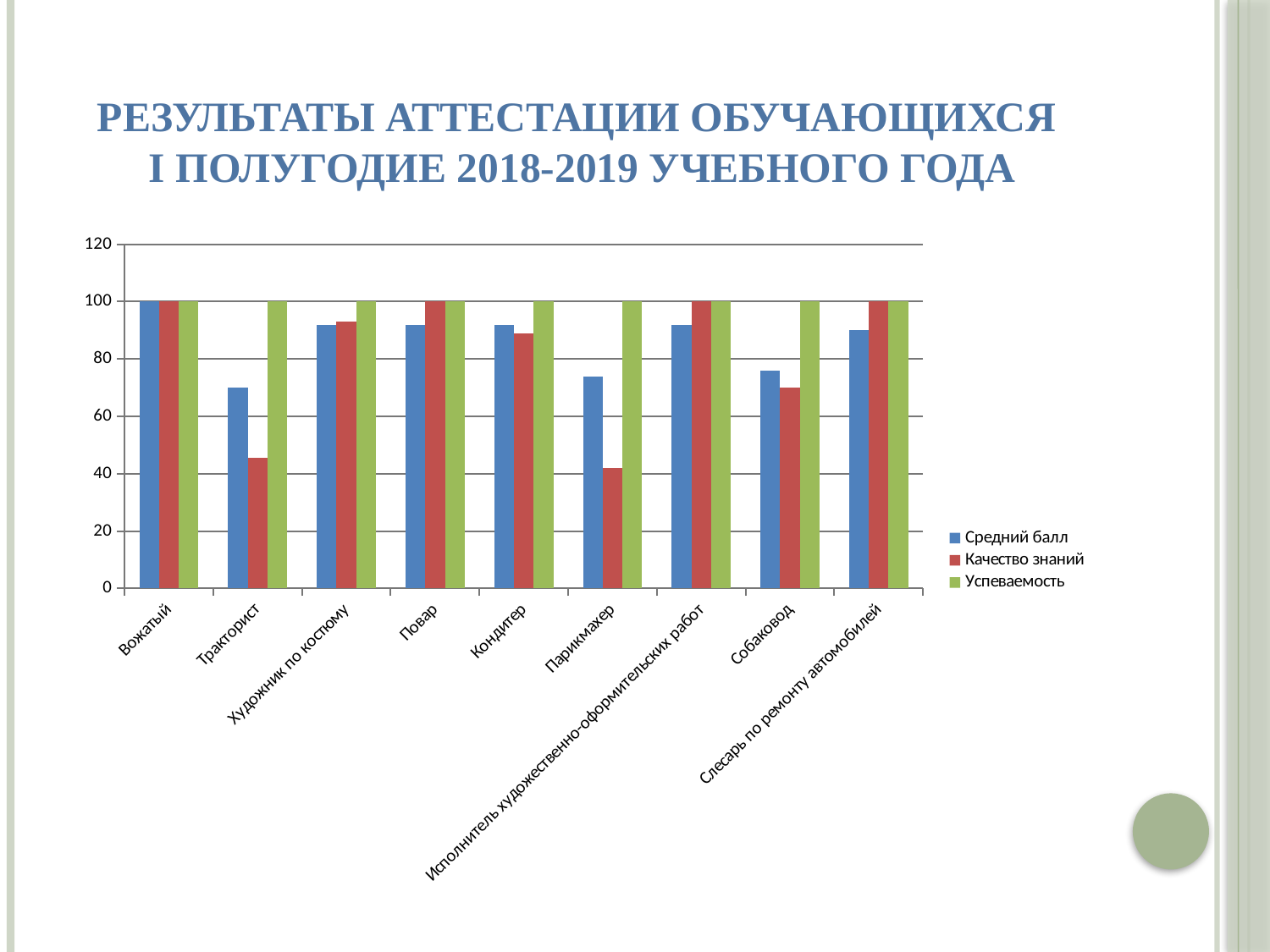
What is the value of Успеваемость for Повар? 100 What is the value of Качество знаний for Слесарь по ремонту автомобилей? 100 How many series does the legend list? 3 Is the value of Качество знаний for Парикмахер greater or less than 60? less What is the value of Качество знаний for Вожатый? 100 Which series is shown in green in the legend? Успеваемость What kind of chart is shown on the slide? bar chart How many categories (professions) are shown on the x axis? 9 Is the value of Качество знаний for Тракторист greater or less than 60? less Which has the larger Качество знаний value: Повар or Кондитер? Повар Is the value of Средний балл for Собаковод greater or less than 80? less Which is larger for Тракторист: Средний балл or Качество знаний? Средний балл